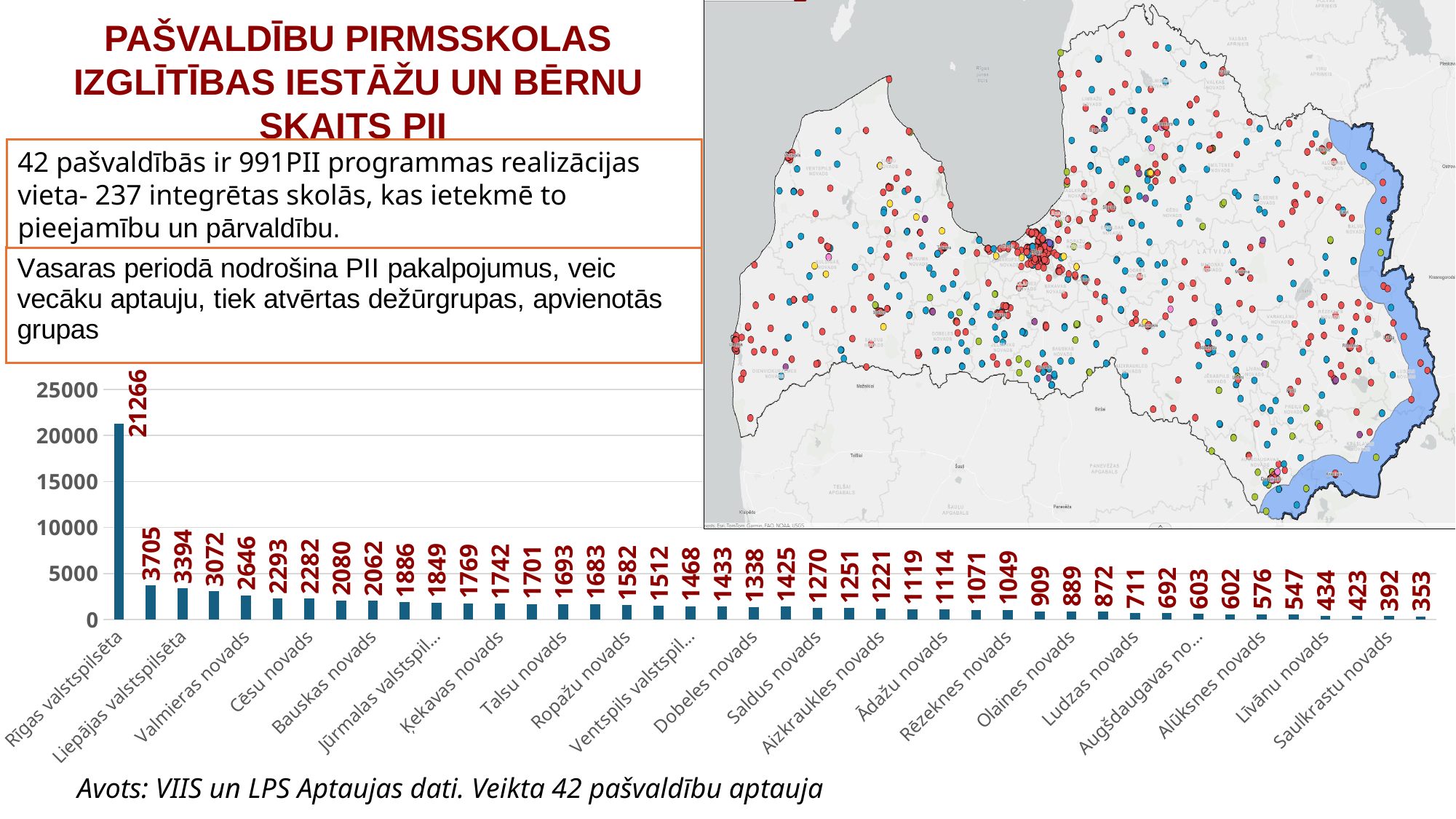
What is the highest tick value shown on the vertical axis of the chart? 25000 Which category has the highest value in the bar chart? Rīgas valstspilsēta Which is larger, the value for Rīgas valstspilsēta or the value for Liepājas valstspilsēta? Rīgas valstspilsēta What is the value for Rīgas valstspilsēta? 21266 What is the difference between the largest bar value (21266) and the smallest bar value (353)? 20913 Is the value for Rīgas valstspilsēta greater or less than 20000? greater What type of chart is shown on the slide? bar chart How many bars are plotted in the chart? 42 What is the smallest value shown on any bar in the chart? 353 Do the bar values rise or fall from left to right along the x axis? fall What is the second-highest value shown on a bar in the chart? 3705